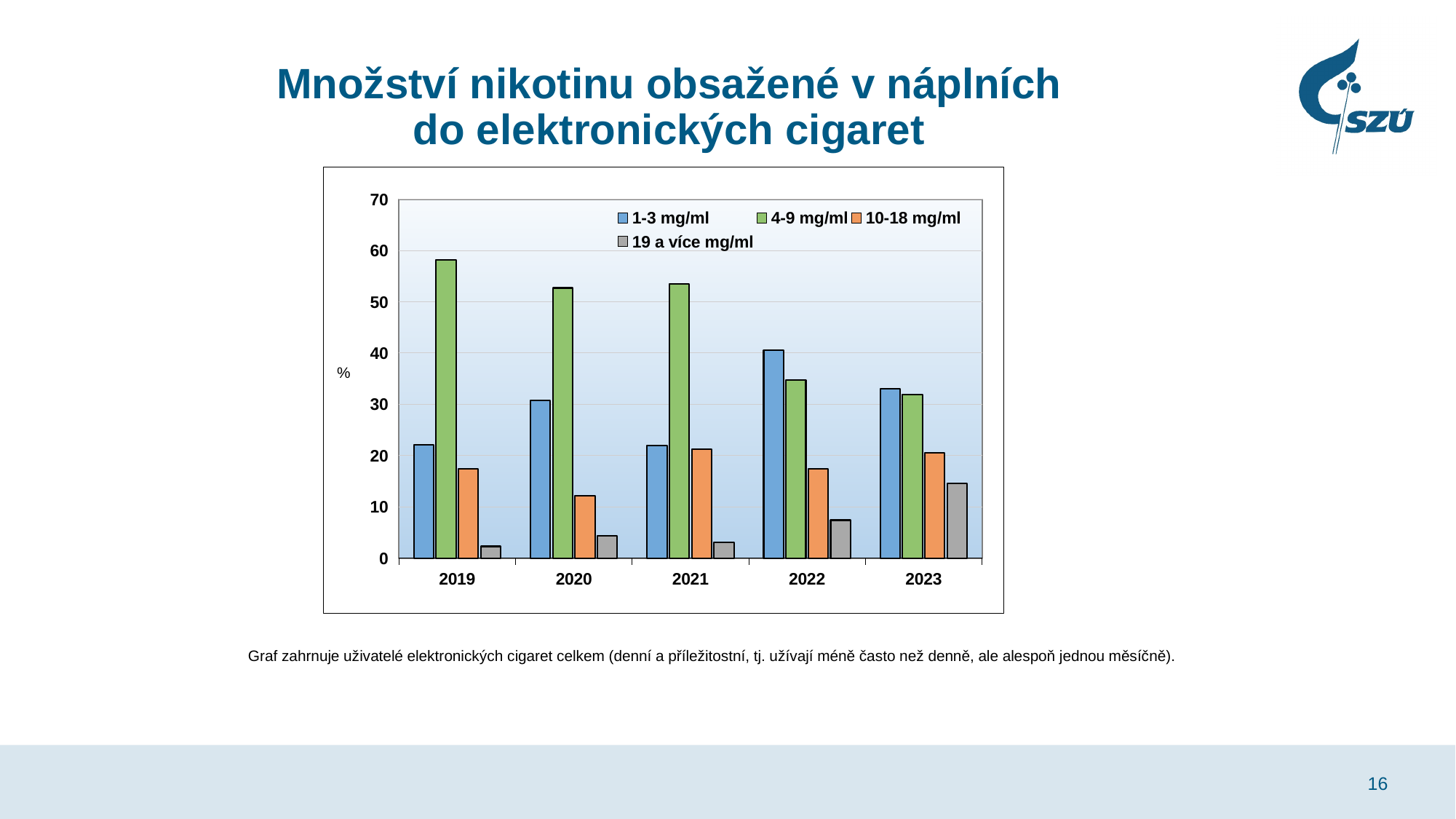
Is the value for 4-9 mg/ml in 2019 greater or less than 50? greater Is the value for 19 a více mg/ml in 2023 greater or less than 10? greater In which year is the value for 4-9 mg/ml the highest? 2019 What unit is shown on the y axis? % How many series does the legend list? 4 In 2021, which series has the highest value? 4-9 mg/ml Is the value for 1-3 mg/ml in 2022 greater or less than 30? greater How many years are shown on the x axis? 5 In which year is the value for 19 a více mg/ml the lowest? 2019 What kind of chart is shown on the slide? bar chart In 2022, which is larger: the value for 1-3 mg/ml or for 4-9 mg/ml? 1-3 mg/ml Does the value for 4-9 mg/ml rise or fall overall from 2019 to 2023? fall